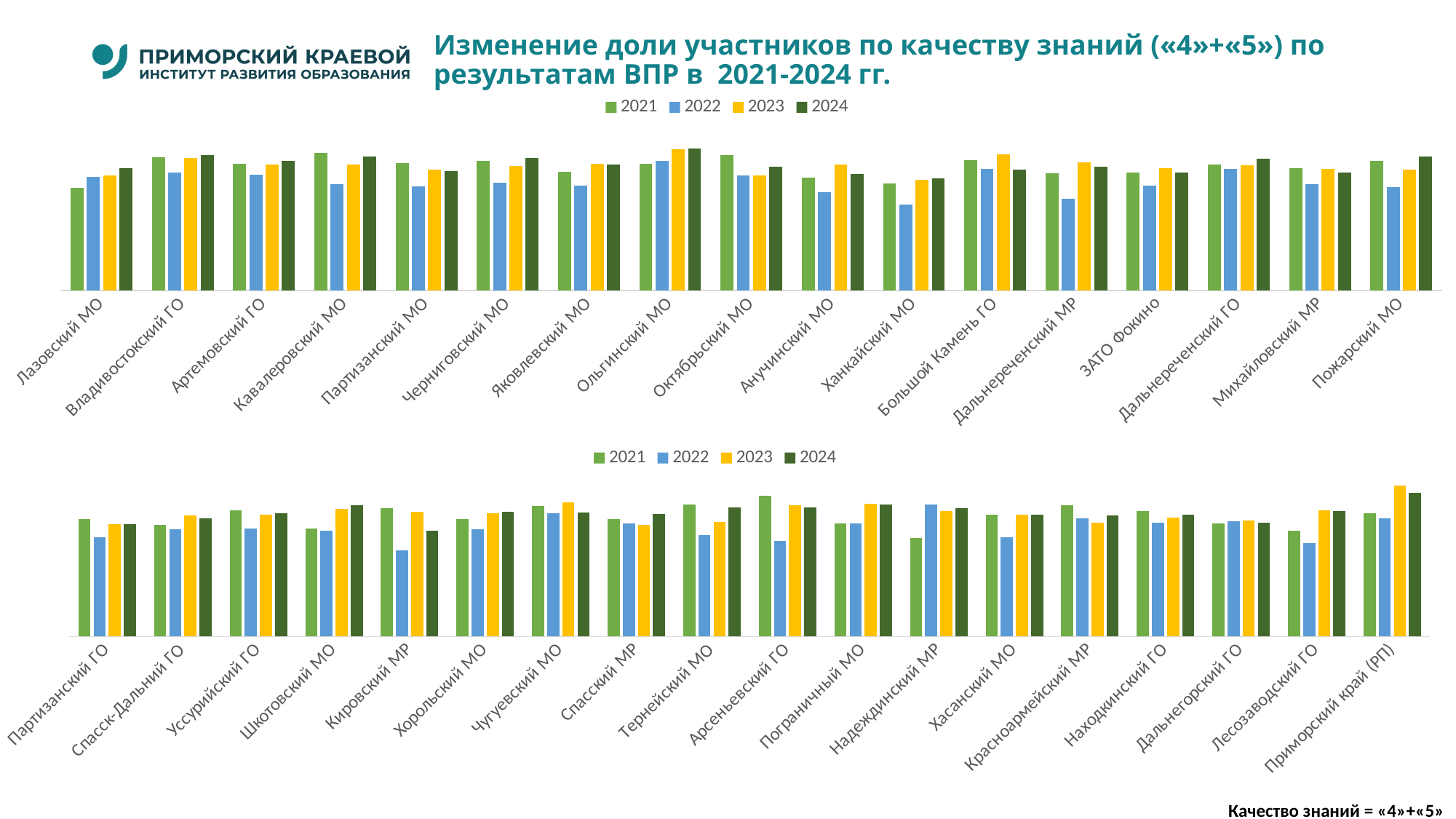
In the bottom chart, which year has the lowest bar for Надеждинский МР? 2021 What colour represents the 2023 series in the charts? yellow In the bottom chart, which year has the highest bar for Приморский край (РП)? 2023 How many categories are shown on the x axis of the bottom chart? 18 In the top chart, for Лазовский МО, which is larger: the 2021 bar or the 2024 bar? 2024 In the bottom chart, for Кировский МР, which is larger: the 2021 bar or the 2022 bar? 2021 What kind of chart is the top chart on the slide? bar chart In the top chart, which year has the lowest bar for Ханкайский МО? 2022 How many categories are shown on the x axis of the top chart? 17 How many series does the legend of the top chart list? 4 In the bottom chart, which year has the lowest bar for Кировский МР? 2022 Which series does the legend of the bottom chart list? 2021, 2022, 2023, 2024